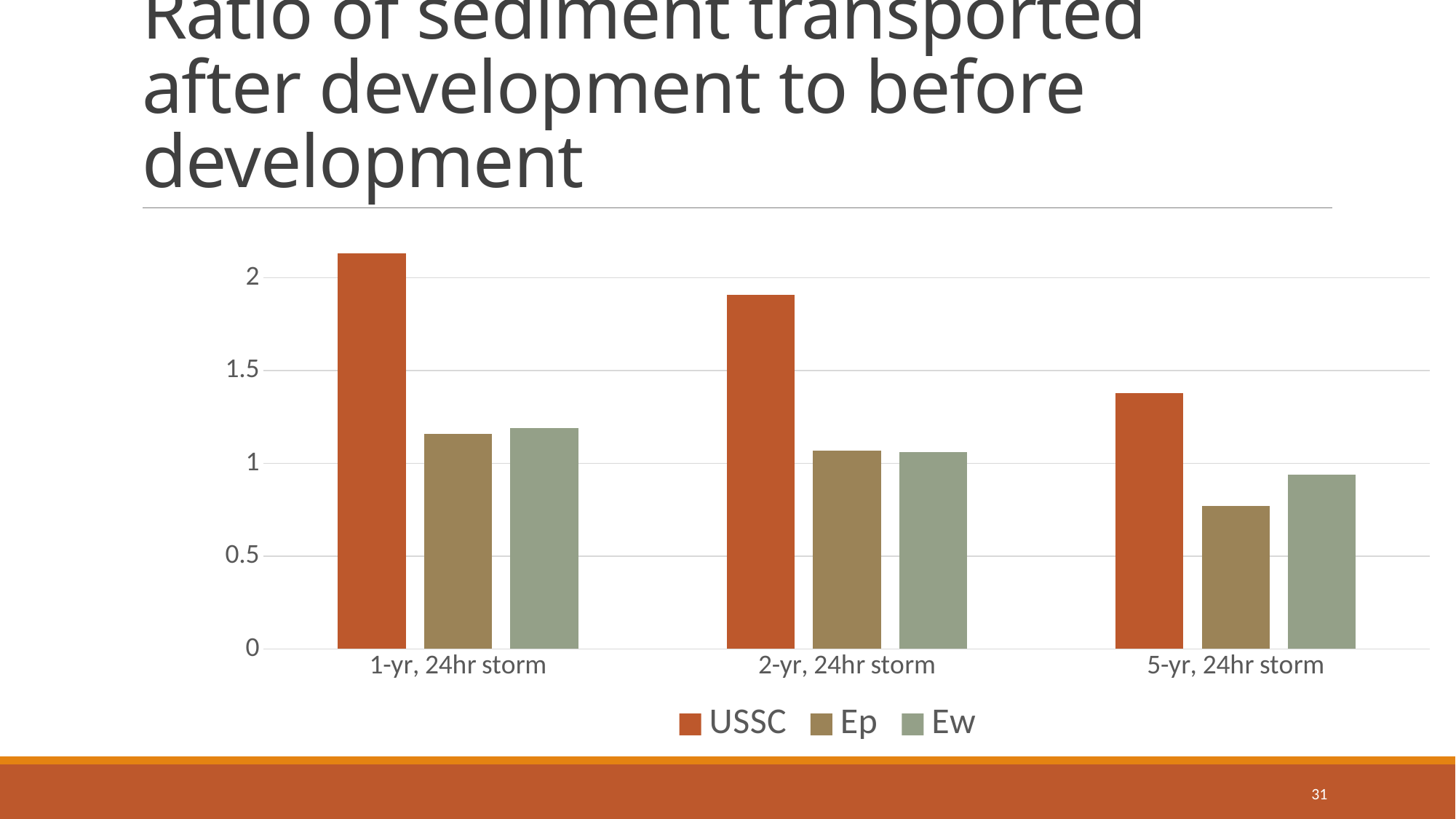
How many series does the legend list? 3 Which series is shown in orange in the legend? USSC Is the Ep value for the 5-yr, 24hr storm greater or less than 1? less For which storm category is the USSC value highest? 1-yr, 24hr storm Is the USSC value for the 5-yr, 24hr storm greater or less than 1.5? less Which series has the lowest value for the 5-yr, 24hr storm? Ep Which series has the highest value for the 1-yr, 24hr storm? USSC Is the USSC value for the 1-yr, 24hr storm greater or less than 2? greater For the 5-yr, 24hr storm, which is larger: Ep or Ew? Ew What kind of chart is shown on the slide? bar chart How many storm categories are shown on the x axis? 3 Do the USSC values rise or fall from the 1-yr storm to the 5-yr storm? fall